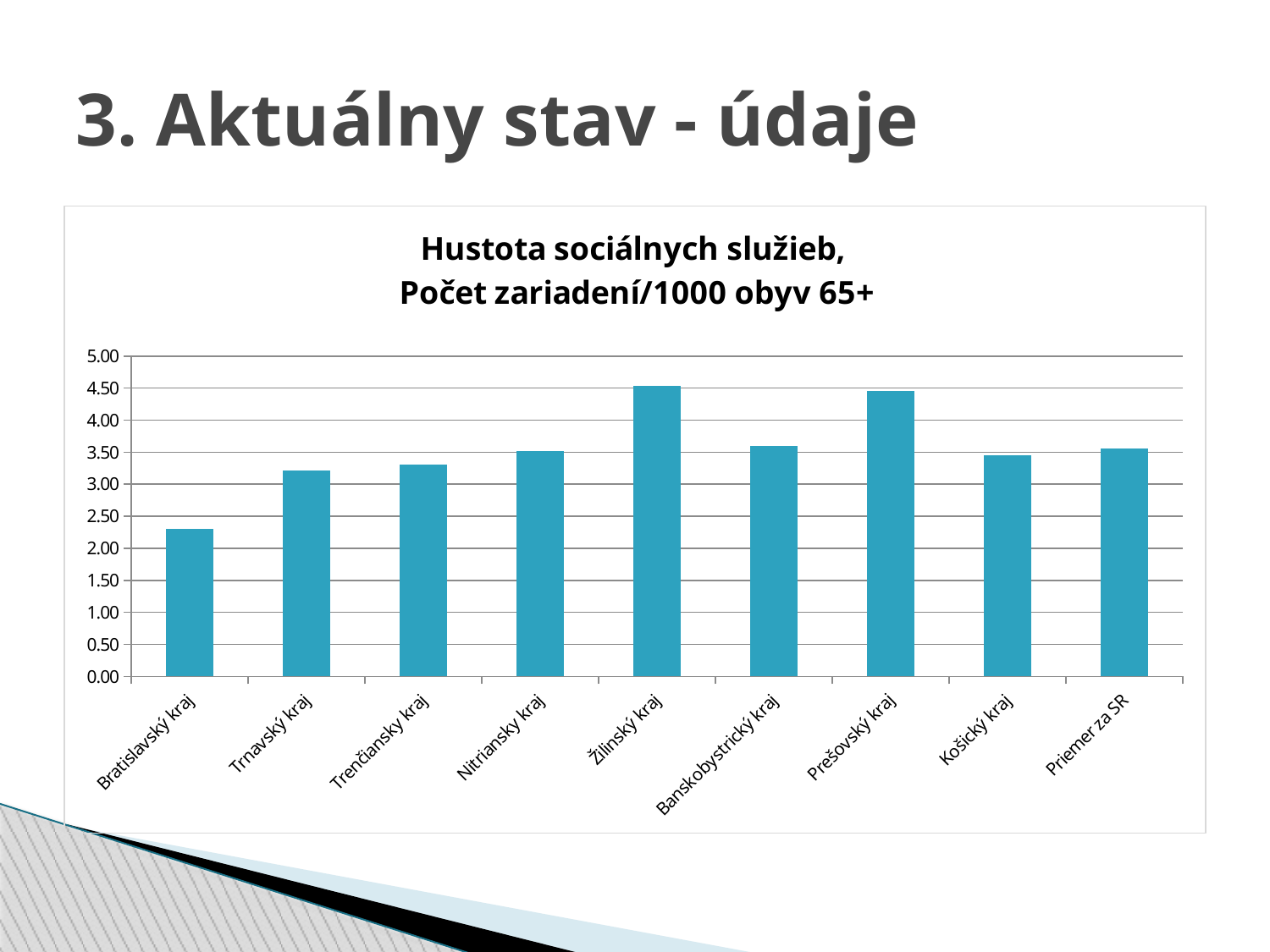
What is the title of the chart? Hustota sociálnych služieb, Počet zariadení/1000 obyv 65+ Which is larger, the value for Bratislavský kraj or the value for Trnavský kraj? Trnavský kraj What kind of chart is shown on the slide? bar chart Is the value for Žilinský kraj greater or less than 4.00? greater Which category has the lowest value in the chart? Bratislavský kraj Is the value for Trnavský kraj greater or less than 3.00? greater Which is larger, the value for Žilinský kraj or the value for Banskobystrický kraj? Žilinský kraj How many categories are plotted on the x axis of the chart? 9 Is the value for Bratislavský kraj greater or less than 2.50? less Which category has the highest value in the chart? Žilinský kraj Which is larger, the value for Prešovský kraj or the value for Košický kraj? Prešovský kraj